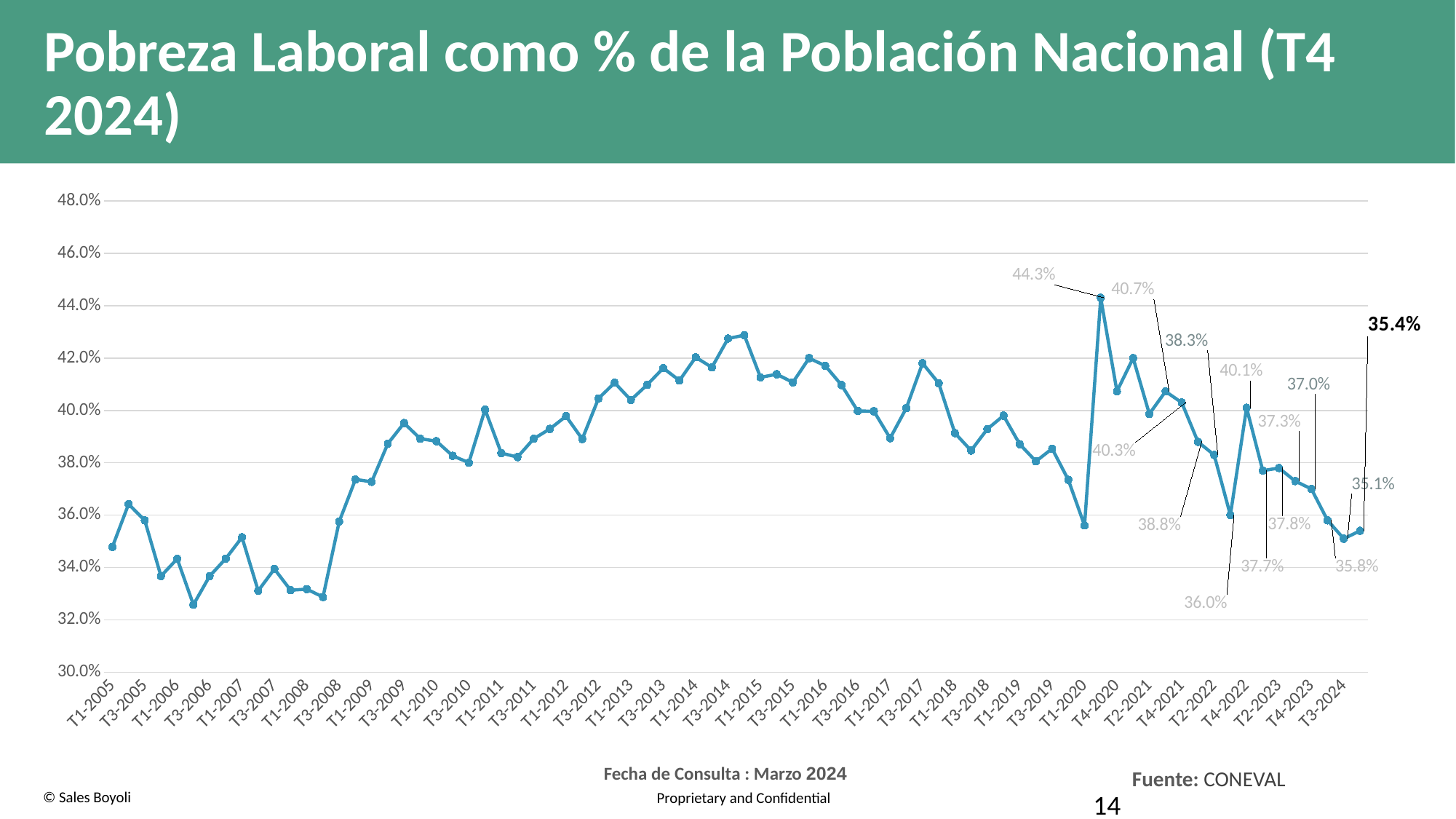
What is the value of the final (most recent) data point on the line, shown in bold? 35.4% What is the highest value labeled on the chart, at the spike after T1-2020? 44.3% What source is cited for the chart data? CONEVAL What is the difference between the labeled peak of 44.3% and the final value of 35.4%? 8.9 percentage points What is the range of the vertical axis? 30.0% to 48.0% What kind of chart is shown on the slide? Line chart What is the lowest value among the data labels printed on the right side of the chart? 35.1% Is the value for T1-2005 greater or less than 36.0%? less Does the line generally rise or fall between T1-2009 and T3-2014? Rise Which is larger: the value at T1-2020 or the value at the spike immediately after it? The spike immediately after it Is the value for T3-2014 greater or less than 42.0%? greater